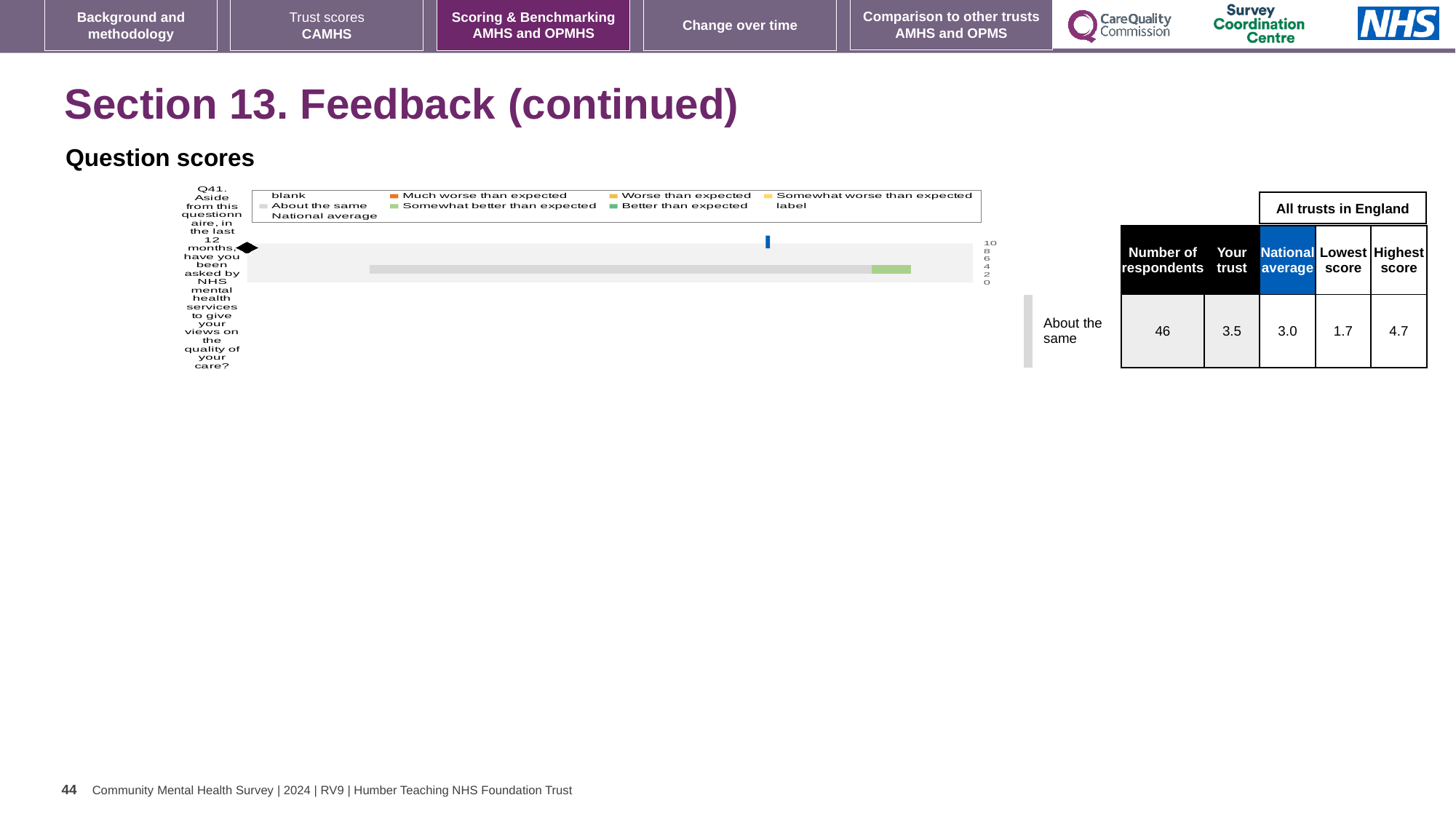
What colour does the chart legend use for 'About the same'? grey How many respondents answered Q41, according to the table beside the chart? 46 According to the table beside the chart, what is the lowest score among all trusts in England for Q41? 1.7 What kind of chart is shown on the slide? bar chart According to the table beside the chart, what is the national average score for Q41? 3.0 Which question number is plotted in the chart? Q41 Is the 'Your trust' score for Q41 larger or smaller than the national average? larger What is the difference between the highest score (4.7) and the lowest score (1.7) for Q41? 3.0 How many questions (categories) are plotted in the chart? 1 According to the table beside the chart, what is the highest score among all trusts in England for Q41? 4.7 According to the table beside the chart, what is the 'Your trust' score for Q41? 3.5 What is the highest value shown on the chart's axis? 10